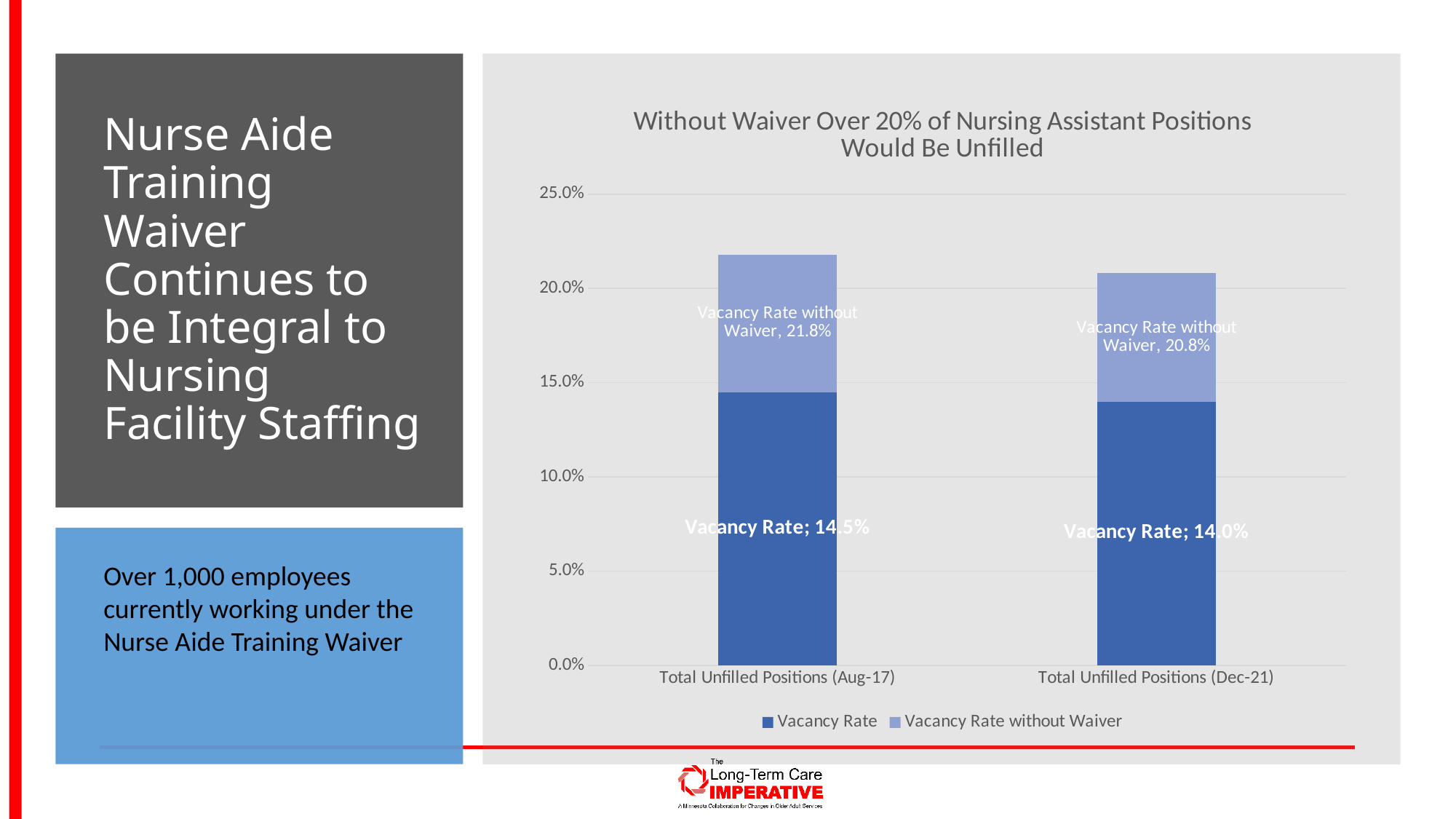
What is the Vacancy Rate for Total Unfilled Positions (Aug-17)? 14.5% What value is labelled for Vacancy Rate without Waiver for Total Unfilled Positions (Dec-21)? 20.8% What is the title of the chart? Without Waiver Over 20% of Nursing Assistant Positions Would Be Unfilled What is the Vacancy Rate for Total Unfilled Positions (Dec-21)? 14.0% How many series does the legend list? 2 Which category has the higher Vacancy Rate, Aug-17 or Dec-21? Total Unfilled Positions (Aug-17) What is the difference between the Vacancy Rate for Aug-17 and the Vacancy Rate for Dec-21? 0.5 percentage points What is the difference between the Vacancy Rate without Waiver labels for Aug-17 and Dec-21? 1.0 percentage points What value is labelled for Vacancy Rate without Waiver for Total Unfilled Positions (Aug-17)? 21.8% What kind of chart is shown on the slide? Stacked bar chart How many categories are shown on the x axis? 2 Is the top of the stacked bar for Total Unfilled Positions (Dec-21) greater or less than 20.0%? greater